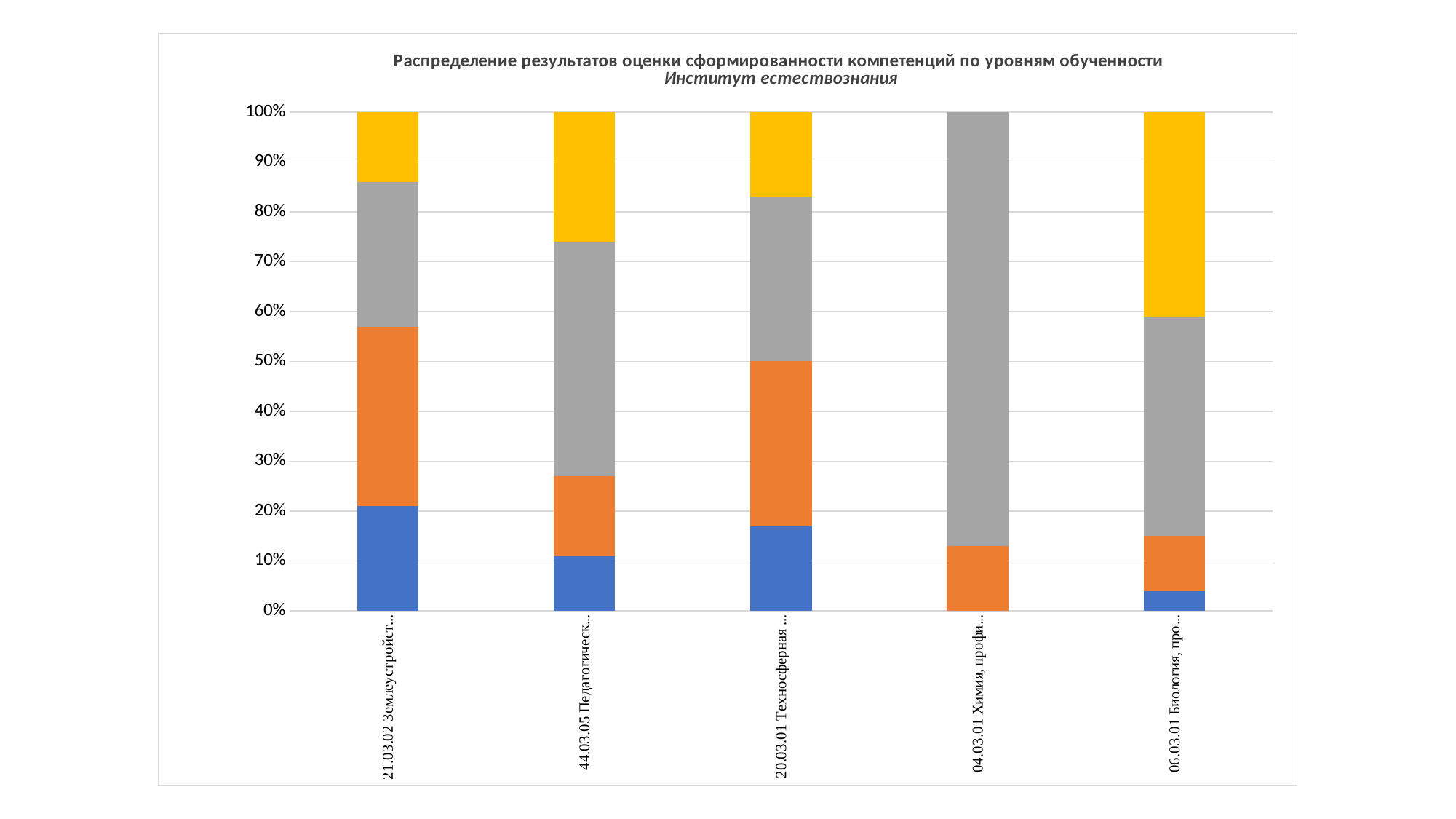
Which category has the largest grey segment? 04.03.01 Химия How many categories (bars) are plotted on the chart? 5 Is the blue segment for 44.03.05 greater or less than 20%? less Which category has no blue (bottom) segment at all? 04.03.01 Химия Which has the larger blue (bottom) segment: 21.03.02 or 44.03.05? 21.03.02 What is the highest value shown on the vertical axis? 100% Is the top of the orange segment for 21.03.02 greater or less than 50%? greater Which category has no yellow (top) segment? 04.03.01 Химия What is the italic subtitle shown under the chart title? Институт естествознания Is the top of the grey segment for 06.03.01 greater or less than 70%? less Which category has the largest yellow (top) segment? 06.03.01 Биология What kind of chart is shown on the slide? Stacked bar chart